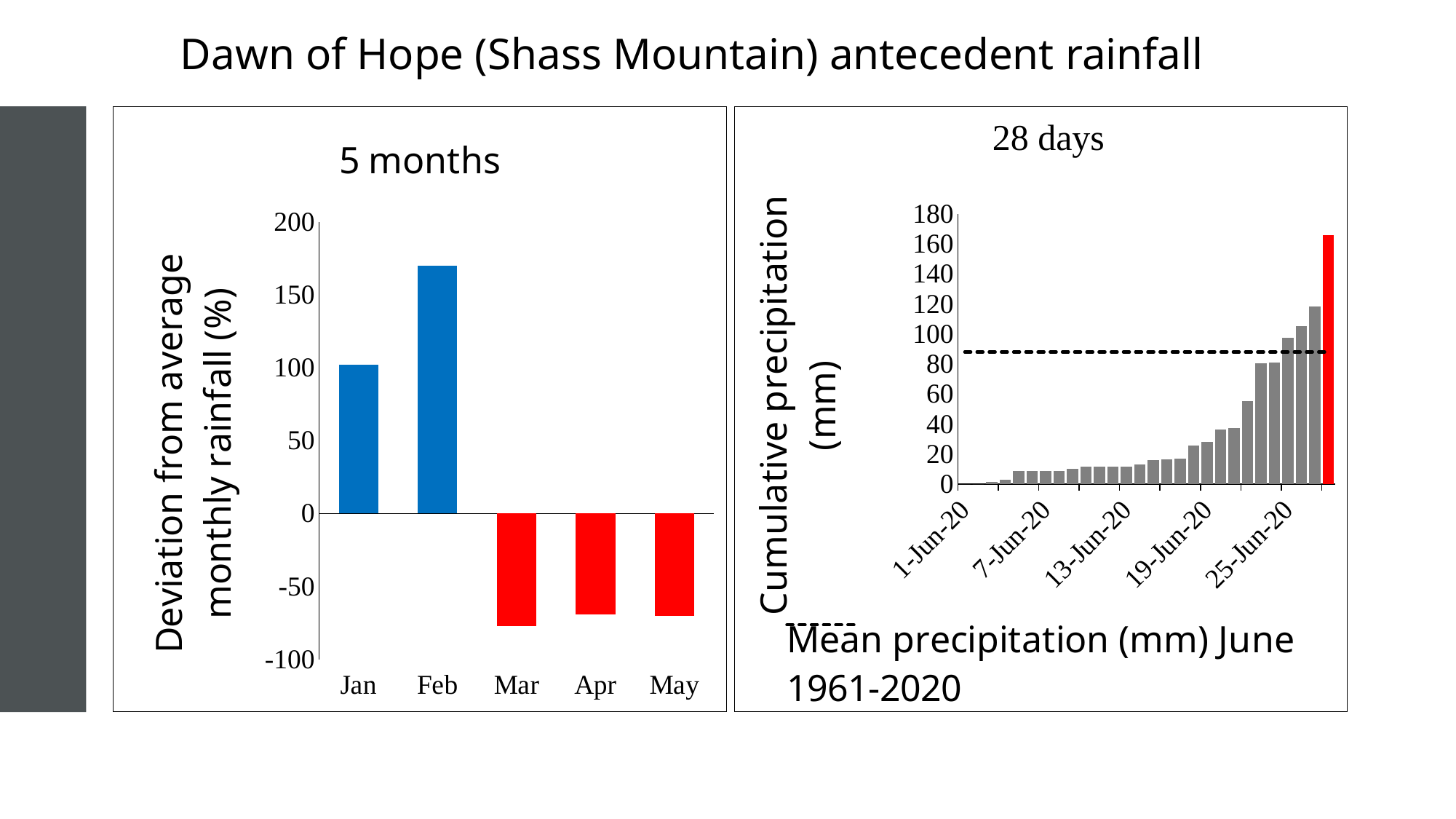
In the '28 days' chart, do the cumulative precipitation values rise or fall along the x axis? rise In the '28 days' chart, is the value of the final red bar greater or less than 140? greater In the '5 months' chart, what kind of chart is shown? bar chart In the '5 months' chart, which is larger, the value for Jan or the value for Feb? Feb In the '5 months' chart, is the value for Jan greater or less than 50? greater In the '28 days' chart, what does the dashed horizontal line represent? Mean precipitation (mm) June 1961-2020 In the '28 days' chart, what kind of chart is shown? combination bar and line chart In the '5 months' chart, which month has the highest deviation from average monthly rainfall? Feb In the '5 months' chart, is the value for Feb greater or less than 150? greater In the '5 months' chart, which months are shown with red bars? Mar, Apr, May In the '5 months' chart, how many months are plotted? 5 In the '5 months' chart, which month has the lowest deviation from average monthly rainfall? Mar